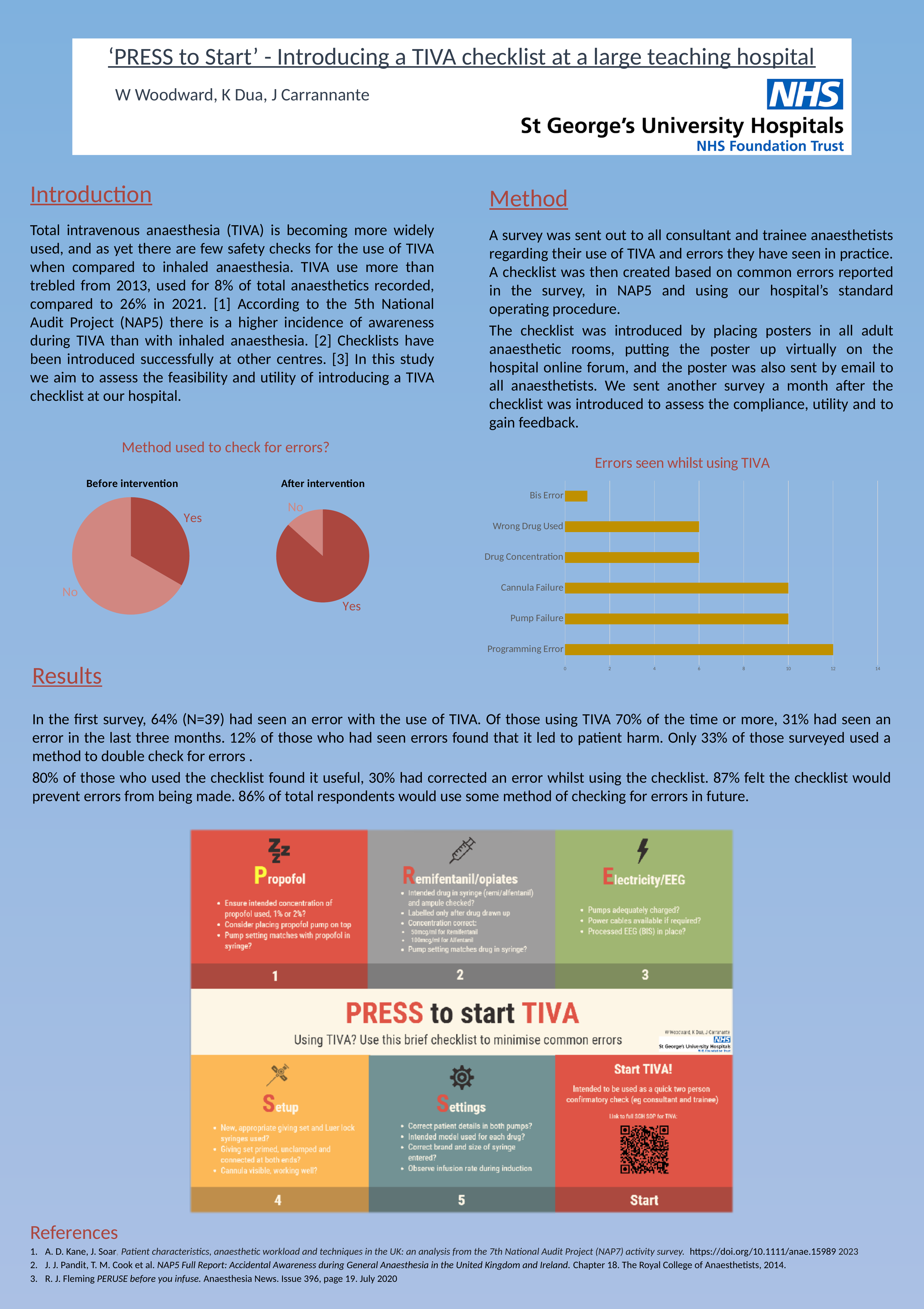
How many error categories are shown in the 'Errors seen whilst using TIVA' chart? 6 In the 'Errors seen whilst using TIVA' chart, is the value for Bis Error greater or less than 2? less In the 'Errors seen whilst using TIVA' chart, what is the value for Cannula Failure? 10 In the 'Errors seen whilst using TIVA' chart, what is the difference between Programming Error and Pump Failure? 2 In the 'Errors seen whilst using TIVA' chart, which is larger: Pump Failure or Drug Concentration? Pump Failure In the 'After intervention' pie chart under 'Method used to check for errors?', which slice is larger: Yes or No? Yes In the 'Before intervention' pie chart under 'Method used to check for errors?', which slice is larger: Yes or No? No In the 'Errors seen whilst using TIVA' chart, what is the value for Wrong Drug Used? 6 In the 'Errors seen whilst using TIVA' chart, which error category has the highest value? Programming Error What kind of chart is 'Errors seen whilst using TIVA'? bar chart In the 'Errors seen whilst using TIVA' chart, which error category has the lowest value? Bis Error In the 'Errors seen whilst using TIVA' chart, what is the value for Programming Error? 12